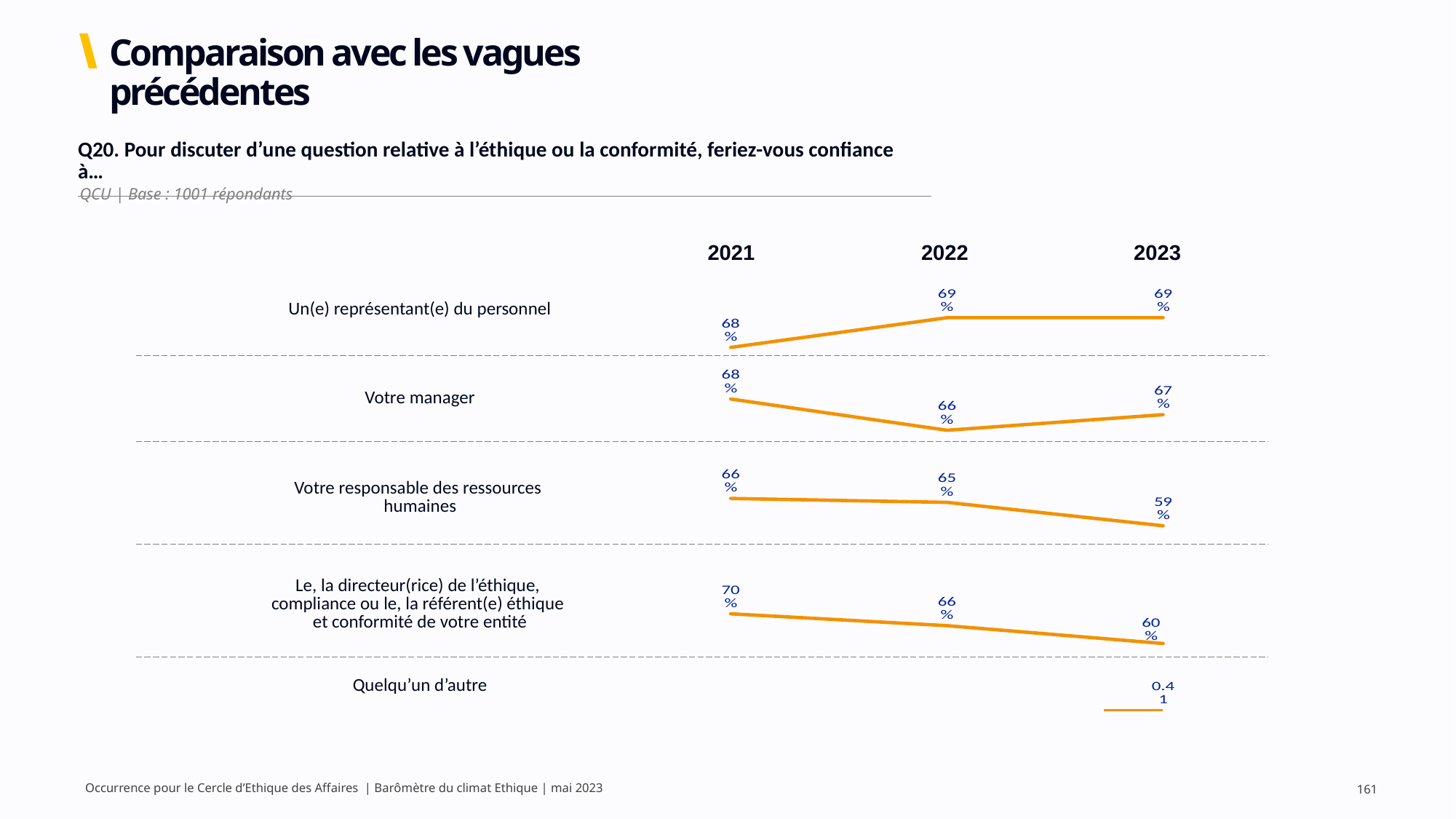
In the chart for "Votre manager", is the 2023 value larger or smaller than the 2022 value? larger In the chart for "Le, la directeur(rice) de l'éthique, compliance ou le, la référent(e) éthique et conformité de votre entité", what is the value for 2021? 70% How many years are shown along the top of the charts? 3 In the chart for "Votre manager", which year has the highest value? 2021 In the chart for "Un(e) représentant(e) du personnel", what is the value for 2021? 68% In the chart for "Le, la directeur(rice) de l'éthique, compliance ou le, la référent(e) éthique et conformité de votre entité", which year has the lowest value? 2023 In the chart for "Votre responsable des ressources humaines", do the values rise or fall from 2021 to 2023? fall In the chart for "Votre responsable des ressources humaines", what is the difference between the 2021 and 2023 values? 7 percentage points In the chart for "Votre manager", what is the value for 2022? 66% In the chart for "Le, la directeur(rice) de l'éthique, compliance ou le, la référent(e) éthique et conformité de votre entité", what is the difference between the 2021 and 2023 values? 10 percentage points What kind of chart is used for each row on this slide? line chart In the chart for "Votre responsable des ressources humaines", what is the value for 2023? 59%